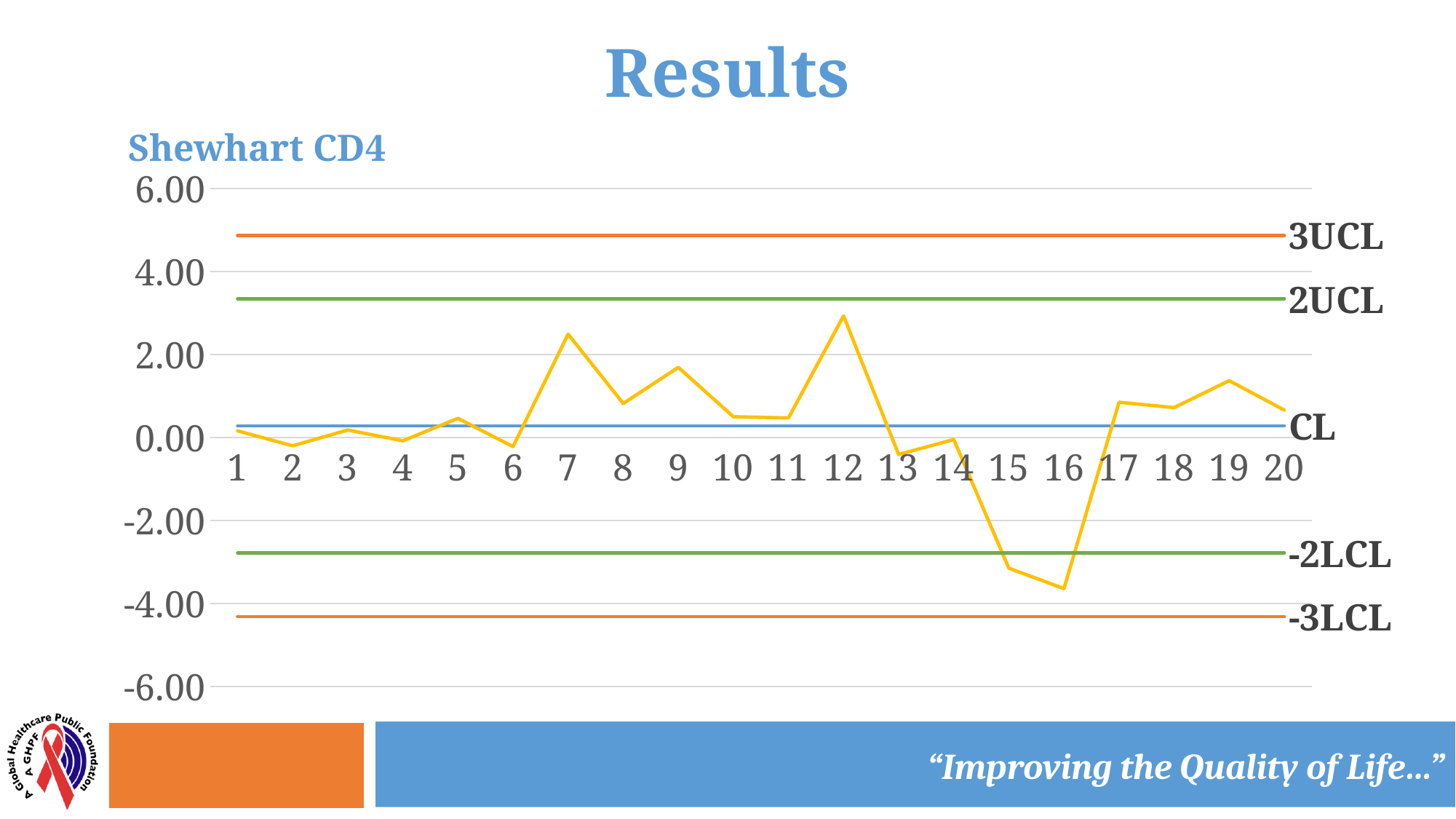
Does the CD4 line rise or fall from point 14 to point 16? fall At which x-axis point does the CD4 line reach its highest value? 12 What is the title of the chart? Shewhart CD4 Is the value of the CD4 line at point 12 greater or less than 2.00? greater What are the labels of the horizontal control lines shown on the right side of the chart? 3UCL, 2UCL, CL, -2LCL, -3LCL Which has the larger value on the CD4 line, point 15 or point 16? point 15 What kind of chart is shown on the slide? line chart Is the value of the CD4 line at point 16 greater or less than -2.00? less At which x-axis point does the CD4 line reach its lowest value? 16 How many points are plotted along the x axis of the Shewhart CD4 chart? 20 Which has the larger value on the CD4 line, point 9 or point 8? point 9 Is the value of the CD4 line at point 2 greater or less than 0.00? less